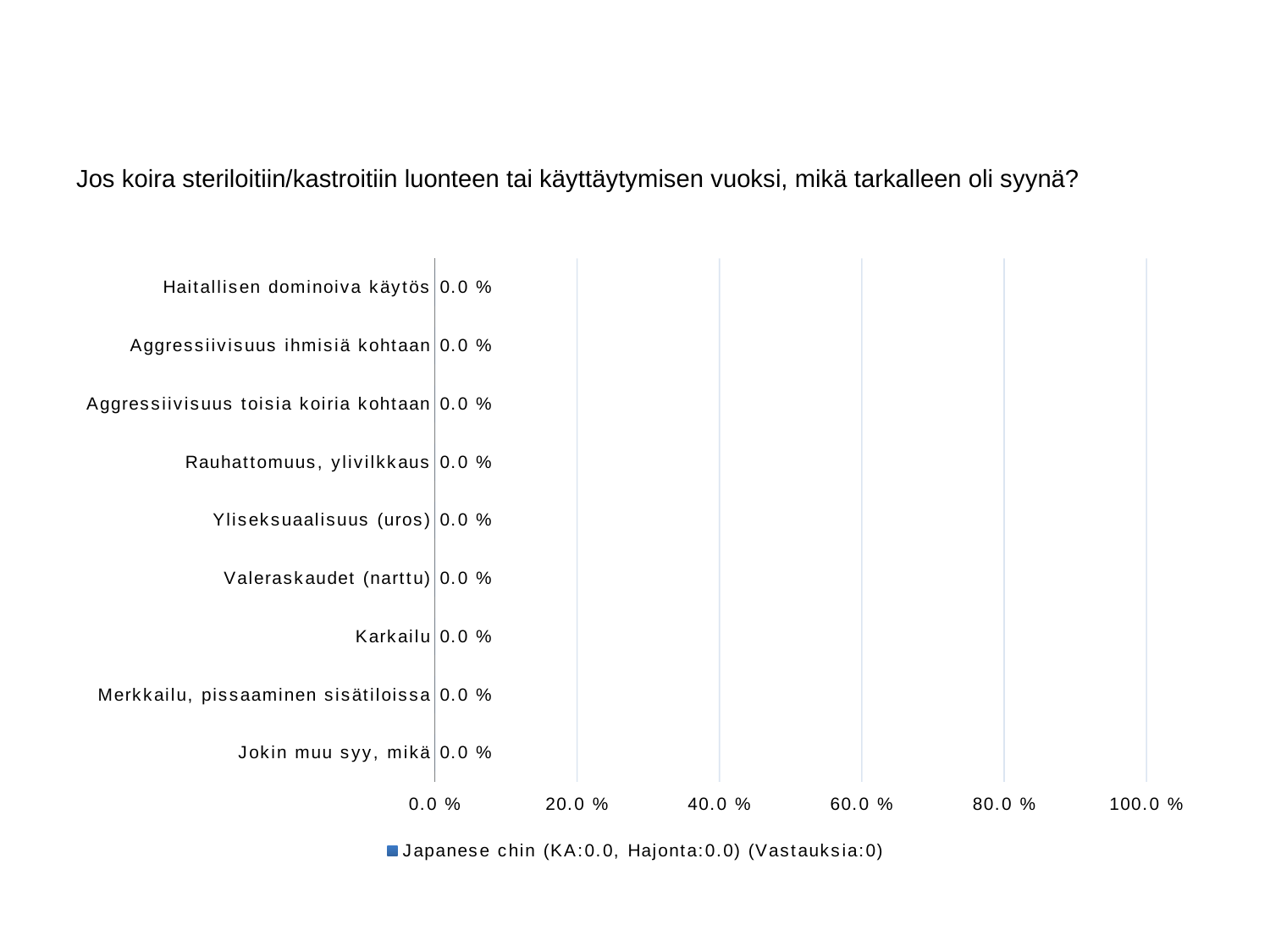
What is the value for Aggressiivisuus ihmisiä kohtaan? 0.0 % What is the highest value shown on the x axis? 100.0 % What is the value for Jokin muu syy, mikä? 0.0 % What series name does the legend show? Japanese chin (KA:0.0, Hajonta:0.0) (Vastauksia:0) What is the value for Karkailu? 0.0 % How many categories are shown on the chart? 9 What is the title of the chart? Jos koira steriloitiin/kastroitiin luonteen tai käyttäytymisen vuoksi, mikä tarkalleen oli syynä? What kind of chart is shown on the slide? bar chart What is the difference between the values for Haitallisen dominoiva käytös and Rauhattomuus, ylivilkkaus? 0.0 % What is the value for Valeraskaudet (narttu)? 0.0 % How many series does the legend list? 1 Is the value for Yliseksuaalisuus (uros) greater or less than 20.0 %? less